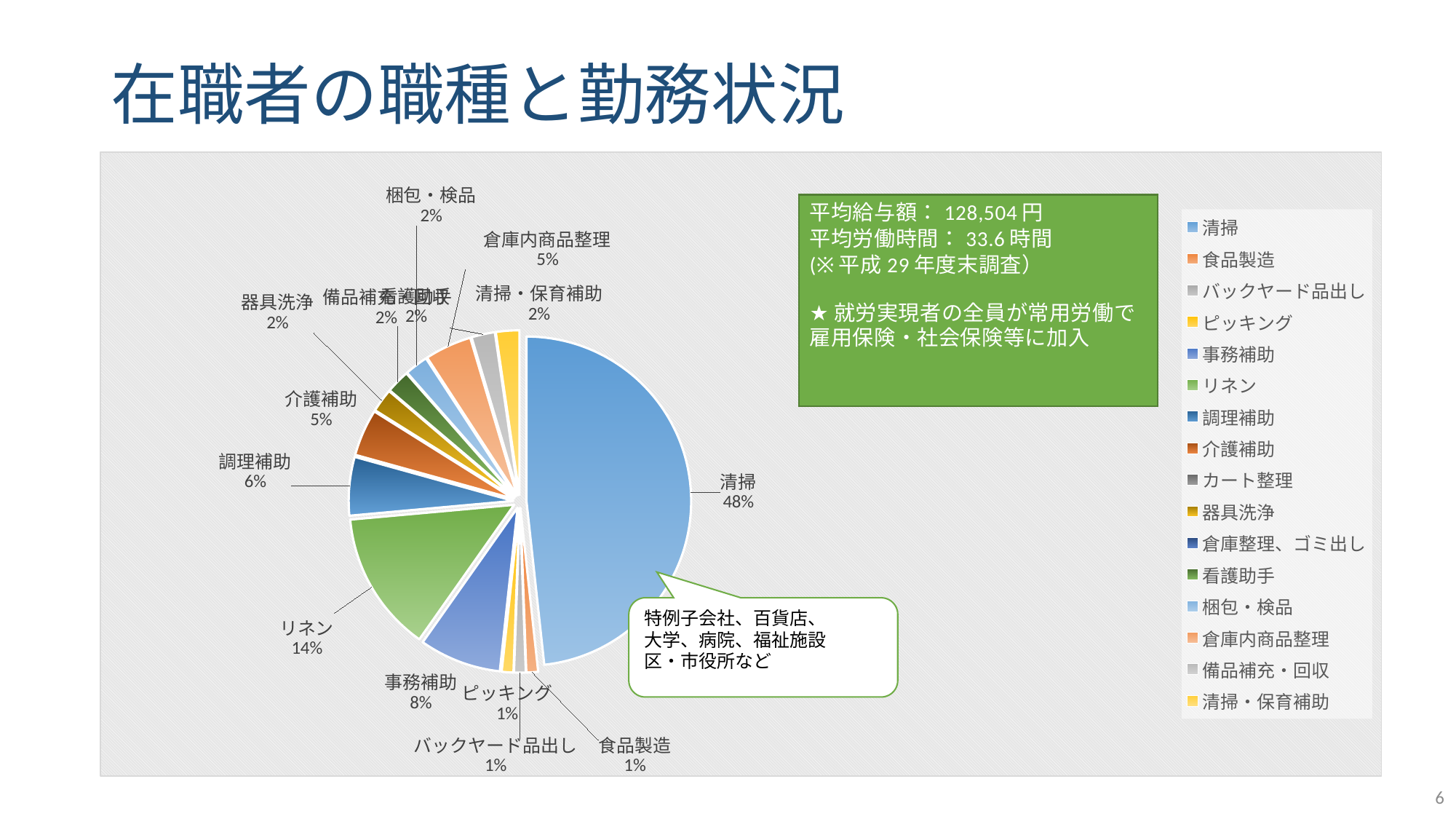
Which category has the largest share of the pie? 清掃 What kind of chart is shown on the slide? pie chart What share of the pie does 事務補助 have? 8% How many entries does the legend list? 16 What share of the pie does 調理補助 have? 6% What share of the pie does 介護補助 have? 5% What is the title of the slide containing the pie chart? 在職者の職種と勤務状況 What is the difference in percentage points between the shares of 清掃 and リネン? 34 percentage points Which has a larger share, 事務補助 or 調理補助? 事務補助 What share of the pie does リネン have? 14% What share of the pie does 清掃 have? 48% What share of the pie does 倉庫内商品整理 have? 5%